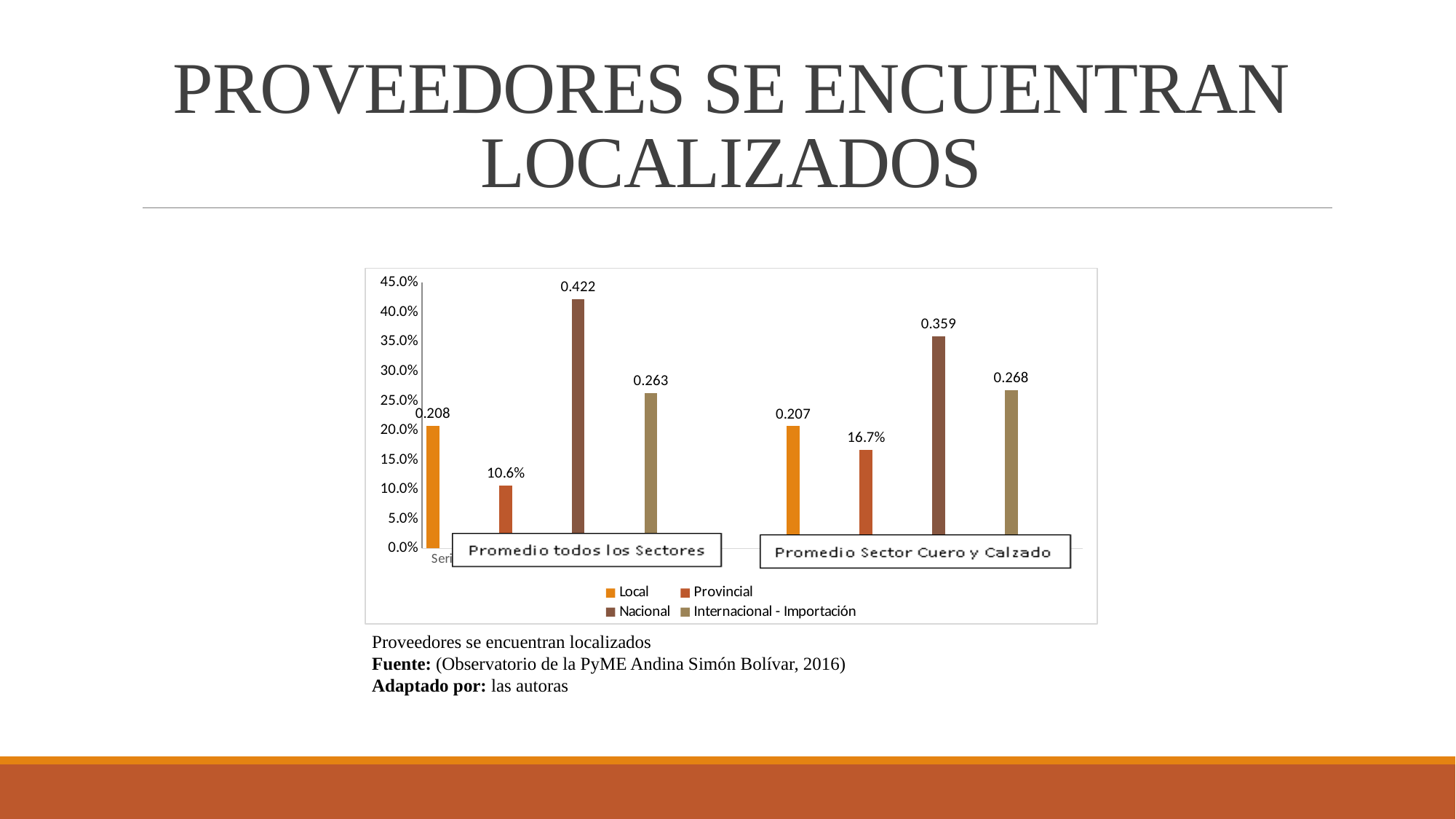
Which series has the highest value for Promedio todos los Sectores? Nacional What is the value of Nacional for Promedio todos los Sectores? 0.422 Which is larger: the Nacional value for Promedio todos los Sectores or for Promedio Sector Cuero y Calzado? Promedio todos los Sectores What is the value of Local for Promedio Sector Cuero y Calzado? 0.207 What is the difference between the Provincial values for Promedio Sector Cuero y Calzado and Promedio todos los Sectores? 6.1% What is the difference between the Nacional values for Promedio todos los Sectores and Promedio Sector Cuero y Calzado? 0.063 Which series has the lowest value for Promedio Sector Cuero y Calzado? Provincial What type of chart is shown on the slide? bar chart What is the value of Provincial for Promedio Sector Cuero y Calzado? 16.7% How many series does the legend list? 4 Is the Provincial value for Promedio todos los Sectores greater or less than 15.0%? less What is the value of Internacional - Importación for Promedio todos los Sectores? 0.263